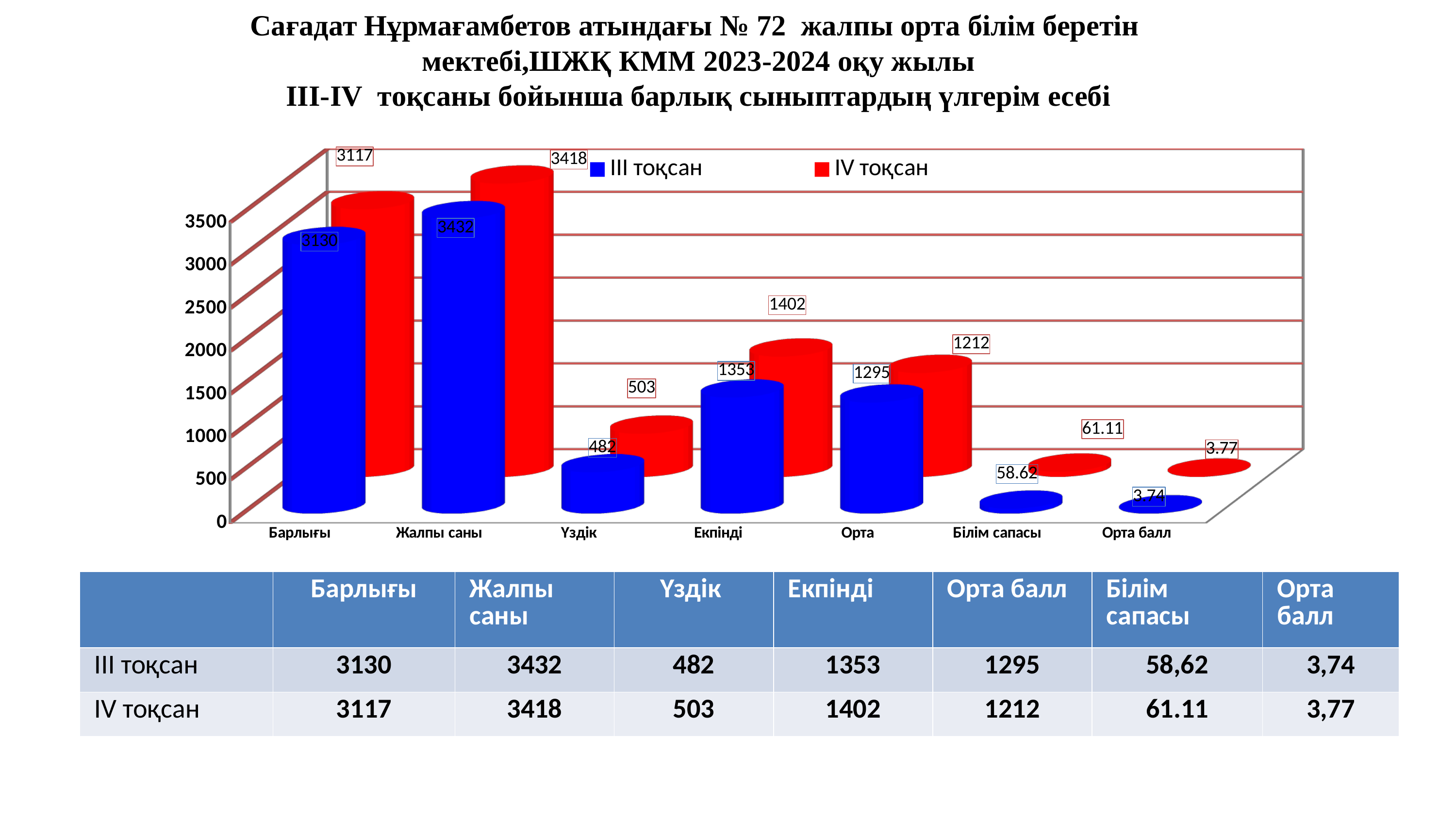
What kind of chart is shown on the slide? bar chart What is the value for Білім сапасы in the III тоқсан series? 58.62 How many categories are shown on the x axis of the chart? 7 What colour represents the IV тоқсан series in the chart? red What is the value for Барлығы in the III тоқсан series? 3130 How many series does the chart legend list? 2 Which category has the highest value in the III тоқсан series? Жалпы саны What is the value for Үздік in the IV тоқсан series? 503 Which category has the lowest value in the IV тоқсан series? Орта балл For Орта, which series has the larger value, III тоқсан or IV тоқсан? III тоқсан What is the difference between the IV тоқсан and III тоқсан values for Екпінді? 49 What is the value for Жалпы саны in the IV тоқсан series? 3418